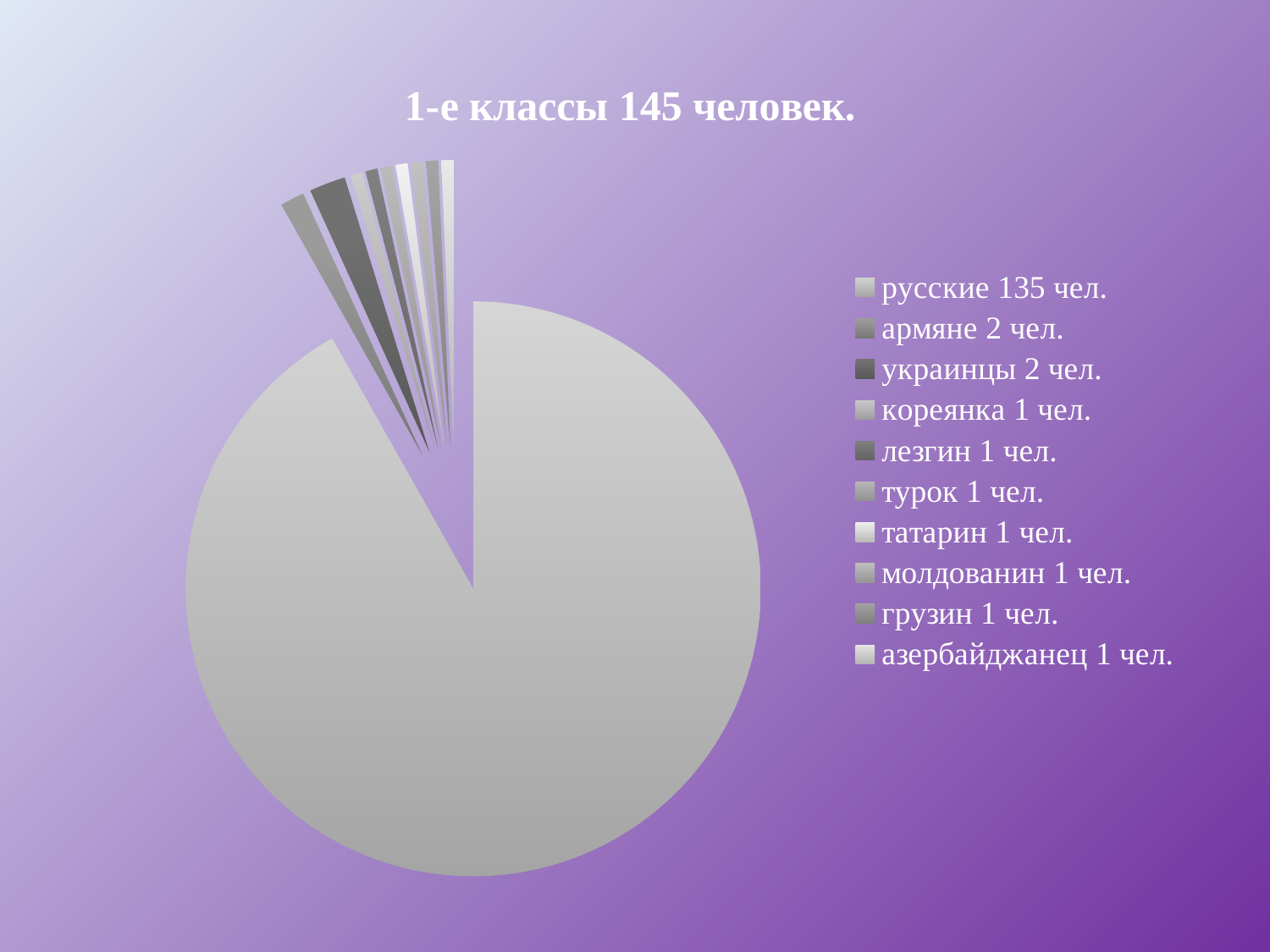
How many categories does the legend of the pie chart list? 10 What is the difference between the number of русские and the number of армяне? 133 Which category has the largest slice of the pie? русские How many people are listed for армяне? 2 чел. Which is larger, the value for армяне or the value for кореянка? армяне What kind of chart is shown on the slide? pie chart How many people are listed for азербайджанец? 1 чел. What is the title of the chart? 1-е классы 145 человек. How many people are listed for украинцы? 2 чел. How many people are listed for русские? 135 чел. Which legend entry is listed last in the legend? азербайджанец 1 чел.